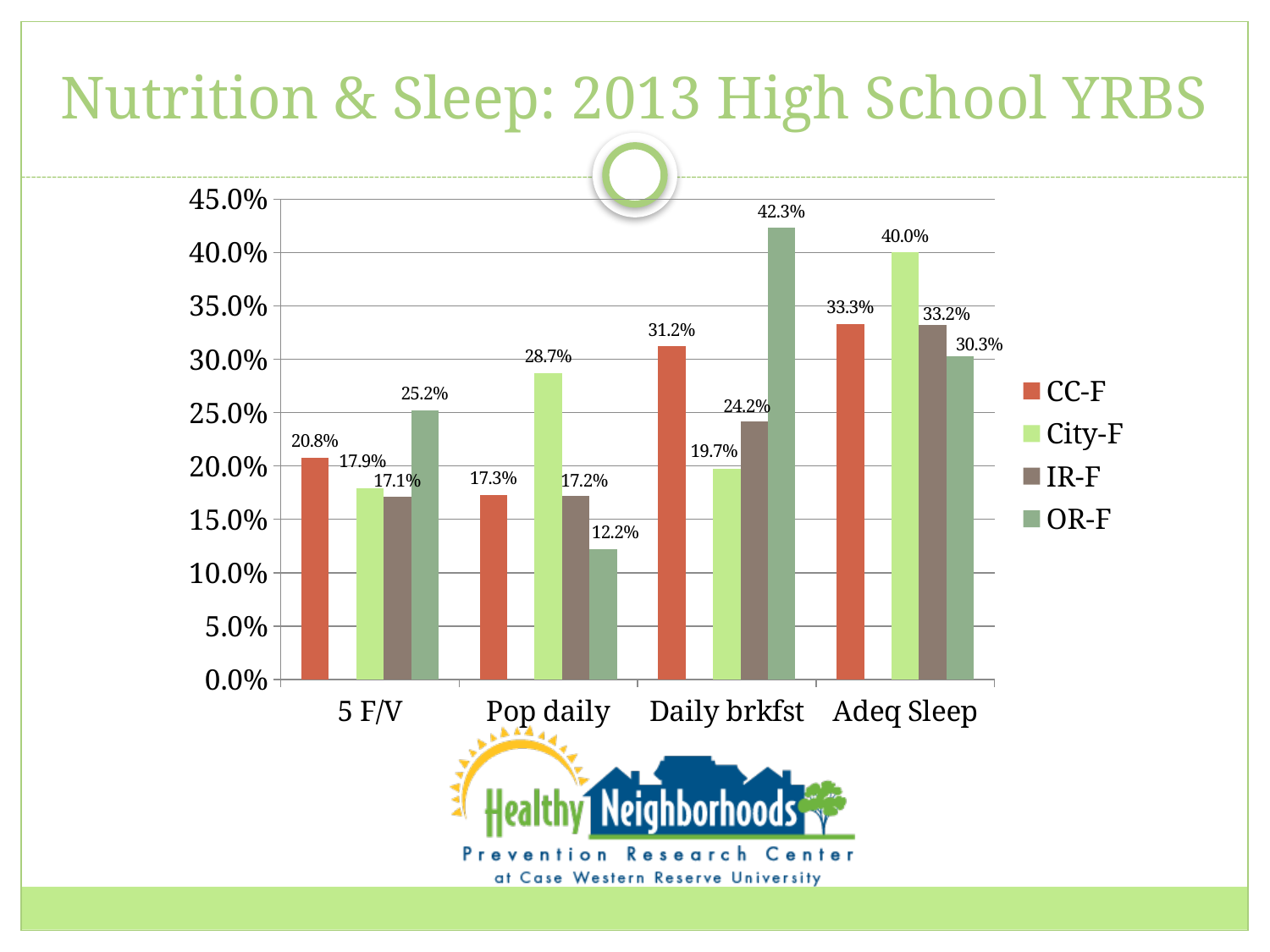
What is the difference between the OR-F and City-F values in the Daily brkfst category? 22.6% What is the value for OR-F in the Daily brkfst category? 42.3% Which series has the highest value in the Adeq Sleep category? City-F How many series does the legend list? 4 What kind of chart is shown on the slide? Bar chart What is the value for IR-F in the Adeq Sleep category? 33.2% What is the title of the slide? Nutrition & Sleep: 2013 High School YRBS What is the value for City-F in the Pop daily category? 28.7% Which series has the lowest value in the Pop daily category? OR-F Which is larger in the 5 F/V category: the OR-F value or the CC-F value? OR-F What is the value for CC-F in the 5 F/V category? 20.8% How many categories are shown on the x axis? 4